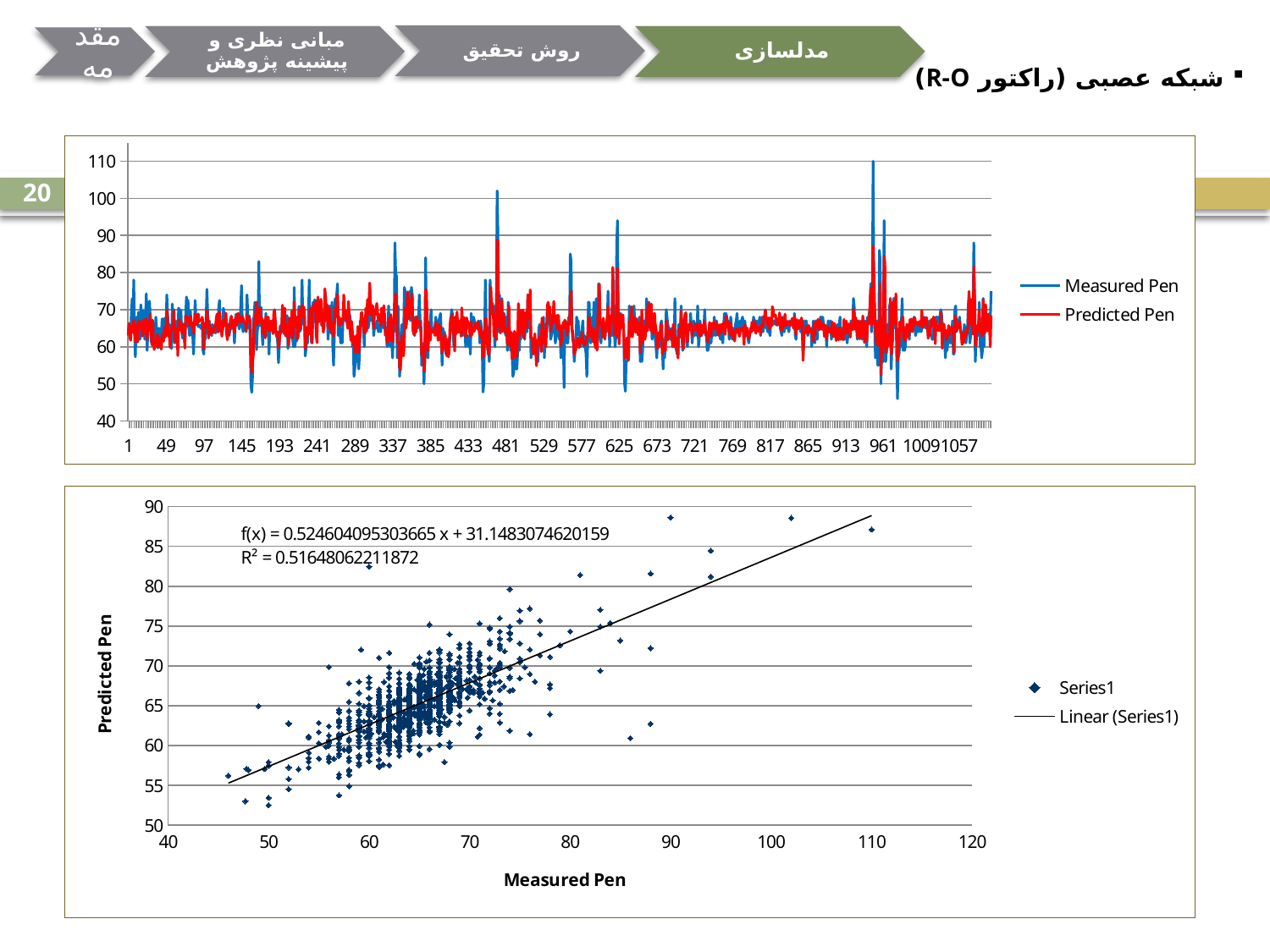
What is the R² value shown on the bottom chart? 0.51648062211872 In the bottom chart, does the fitted line rise or fall as Measured Pen increases? Rises What kind of chart is the top chart on the slide? Line chart How many series does the legend of the top chart list? 2 In the top chart, which series is drawn in red? Predicted Pen In the top chart, is the highest value of the Predicted Pen series greater or less than 100? less What is the lowest value shown on the vertical axis of the top chart? 40 How many series does the legend of the bottom chart list? 2 What is the trend-line equation shown on the bottom chart? f(x) = 0.524604095303665 x + 31.1483074620159 In the top chart, is the highest value of the Measured Pen series greater or less than 100? greater What is the label of the horizontal axis of the bottom chart? Measured Pen What kind of chart is the bottom chart on the slide? Scatter chart